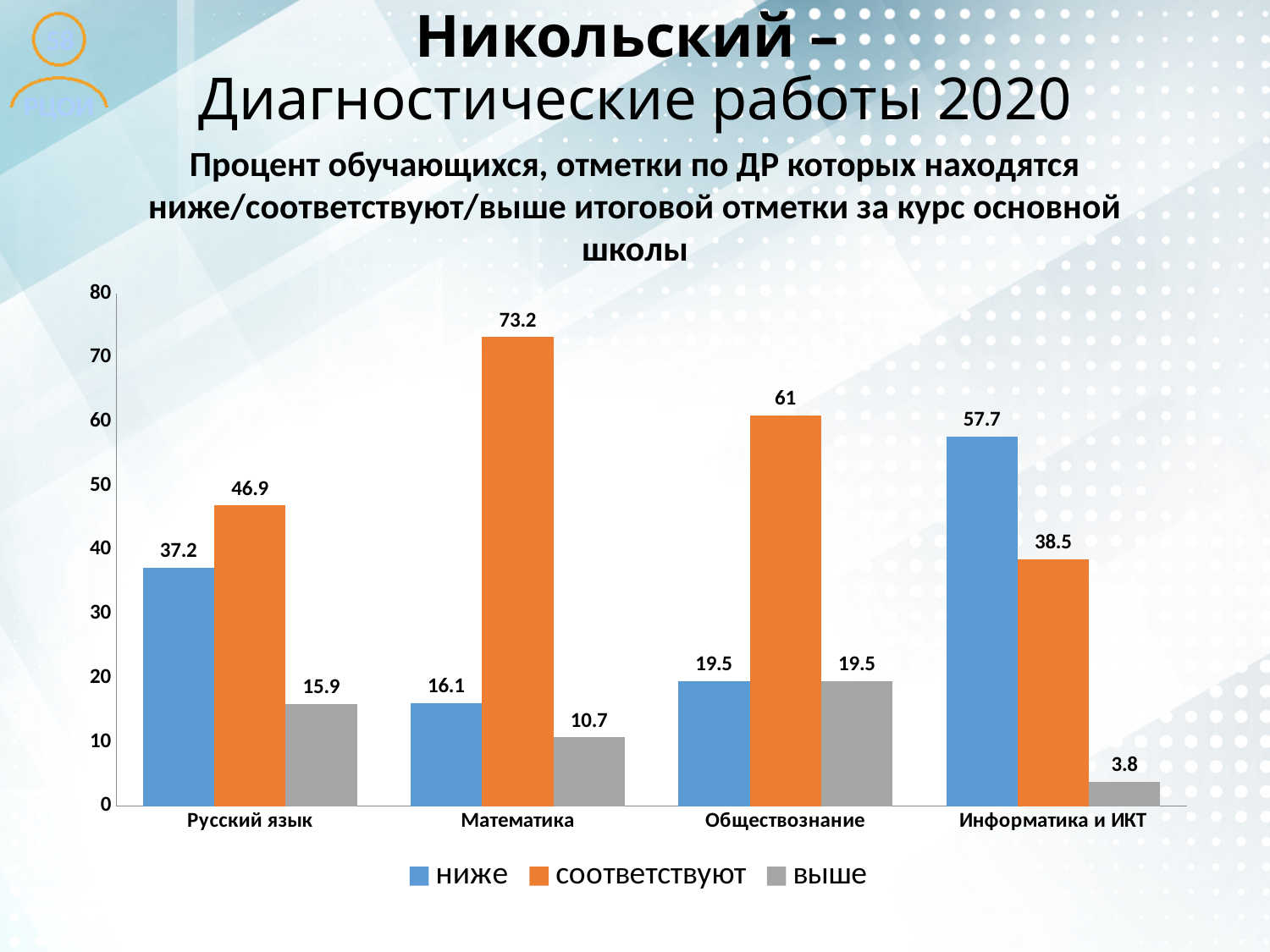
Which colour represents the "выше" series in the legend? grey Is the "ниже" value for Математика greater or less than 20? less Which subject has the highest value in the "соответствуют" series? Математика How many series does the legend list? 3 What is the value of the "ниже" series for Информатика и ИКТ? 57.7 What is the value of the "выше" series for Русский язык? 15.9 For Обществознание, which is larger: the "ниже" value or the "соответствуют" value? соответствуют What kind of chart is shown on the slide? bar chart Which subject has the lowest value in the "выше" series? Информатика и ИКТ What is the value of the "соответствуют" series for Математика? 73.2 How many subjects are shown on the x axis? 4 What is the difference between the "соответствуют" and "ниже" values for Русский язык? 9.7